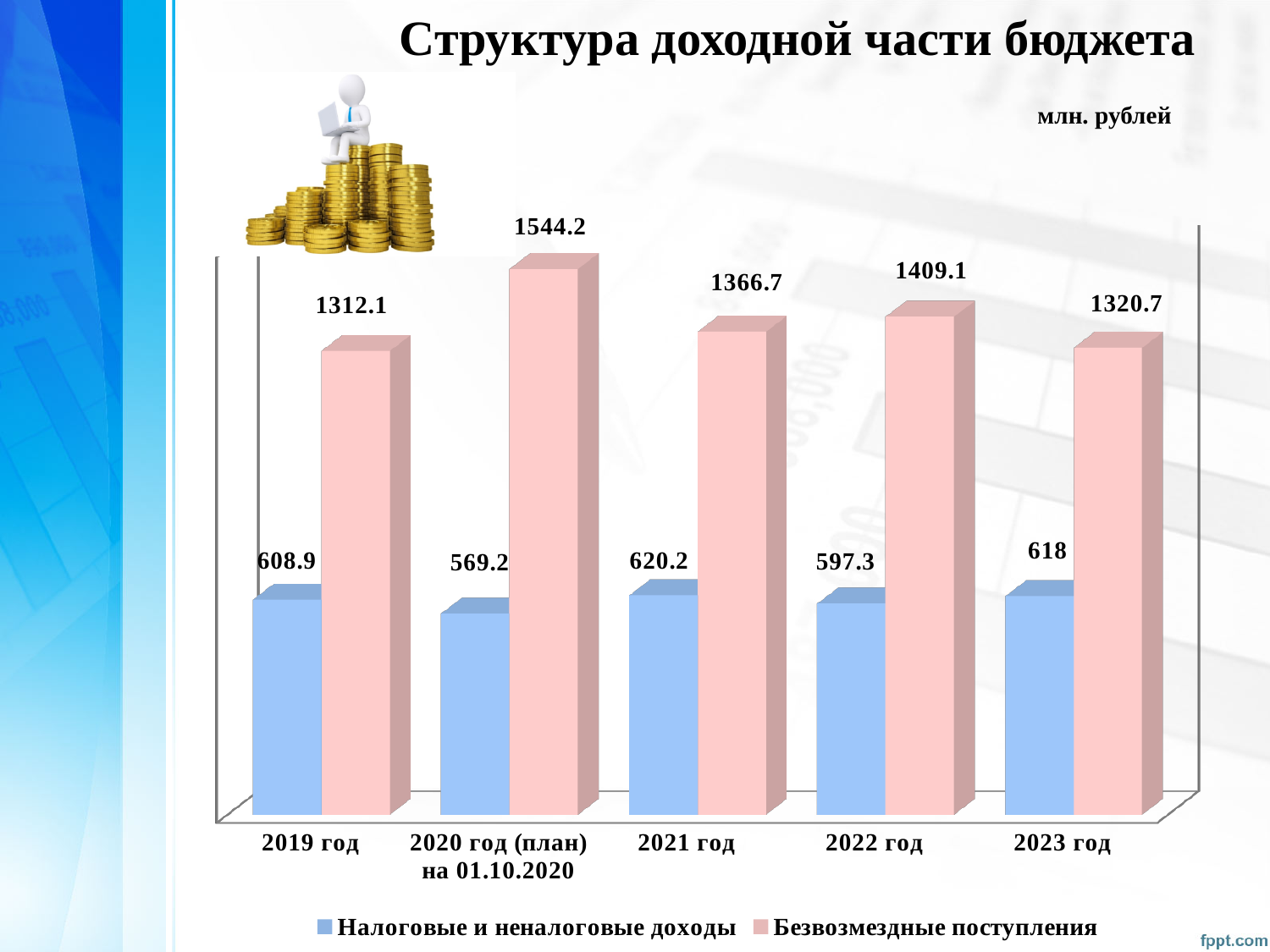
What unit of measurement is indicated on the slide for the chart values? млн. рублей What is the total of Налоговые и неналоговые доходы and Безвозмездные поступления for 2023 год? 1938.7 Which is larger: Налоговые и неналоговые доходы in 2019 год or in 2022 год? 2019 год How many series does the legend list? 2 What is the value of Налоговые и неналоговые доходы for 2021 год? 620.2 How many years (categories) are shown on the x axis? 5 What is the difference between Безвозмездные поступления in 2022 год and 2019 год? 97 What is the value of Безвозмездные поступления for 2020 год (план) на 01.10.2020? 1544.2 Which year has the lowest value for Налоговые и неналоговые доходы? 2020 год (план) на 01.10.2020 What is the value of Налоговые и неналоговые доходы for 2023 год? 618 What kind of chart is shown on the slide? Bar chart Which year has the highest value for Безвозмездные поступления? 2020 год (план) на 01.10.2020